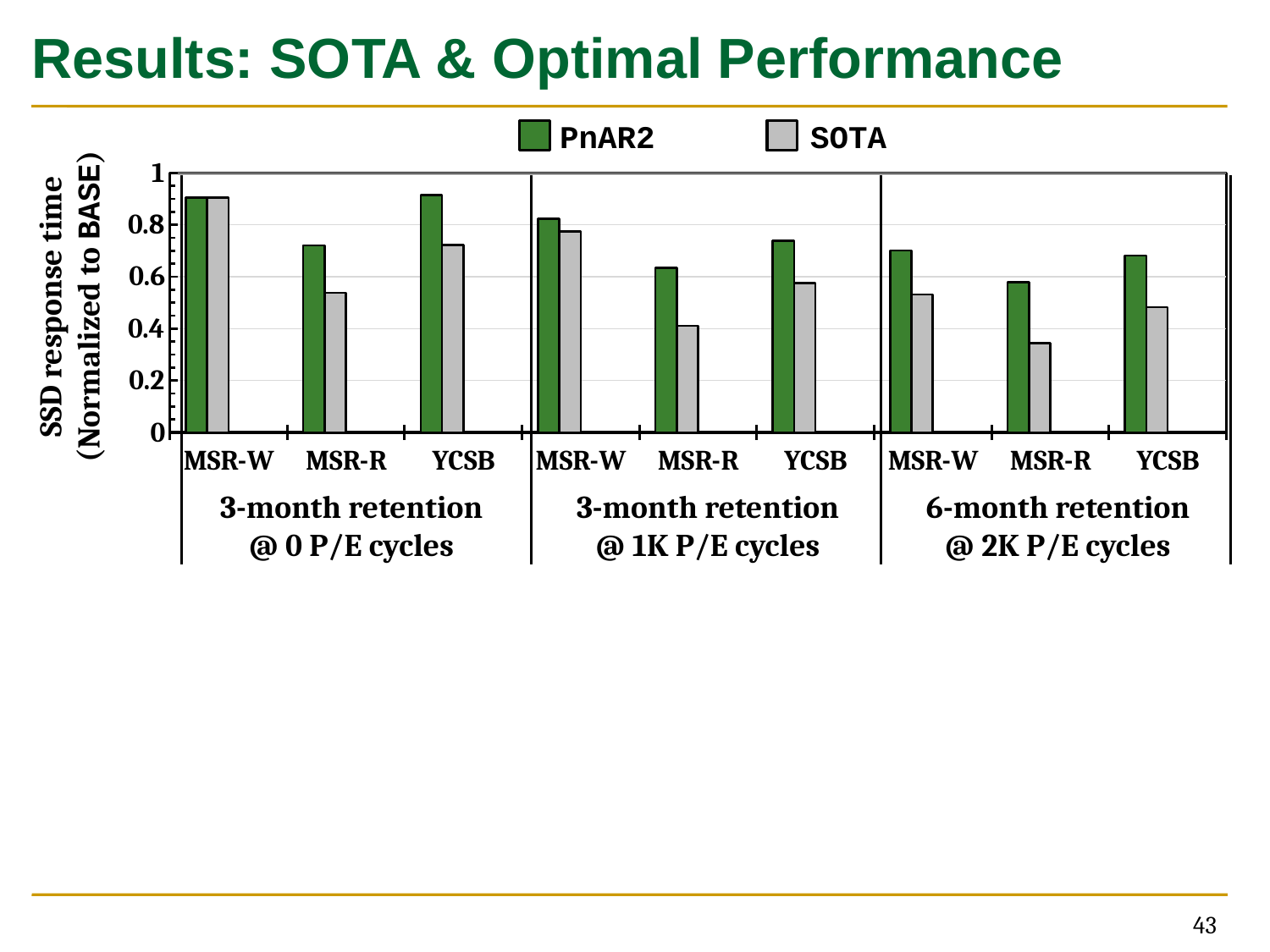
Is the PnAR2 value for YCSB under 3-month retention @ 1K P/E cycles greater or less than 0.8? less Is the PnAR2 value for MSR-W under 3-month retention @ 0 P/E cycles greater or less than 0.8? greater Across the three retention/P/E-cycle sections from left to right, does the SOTA value for MSR-R rise or fall? fall Is the SOTA value for MSR-R under 6-month retention @ 2K P/E cycles greater or less than 0.4? less How many workload groups (pairs of bars) are plotted across the whole chart? 9 How many series does the legend list? 2 How many workloads are shown in the '3-month retention @ 0 P/E cycles' section? 3 Which is larger: the SOTA value for YCSB at 3-month retention @ 0 P/E cycles, or the SOTA value for YCSB at 6-month retention @ 2K P/E cycles? YCSB at 3-month retention @ 0 P/E cycles What is the label of the y axis? SSD response time (Normalized to BASE) For MSR-R under 3-month retention @ 0 P/E cycles, which series has the larger value, PnAR2 or SOTA? PnAR2 What kind of chart is shown on the slide? Bar chart